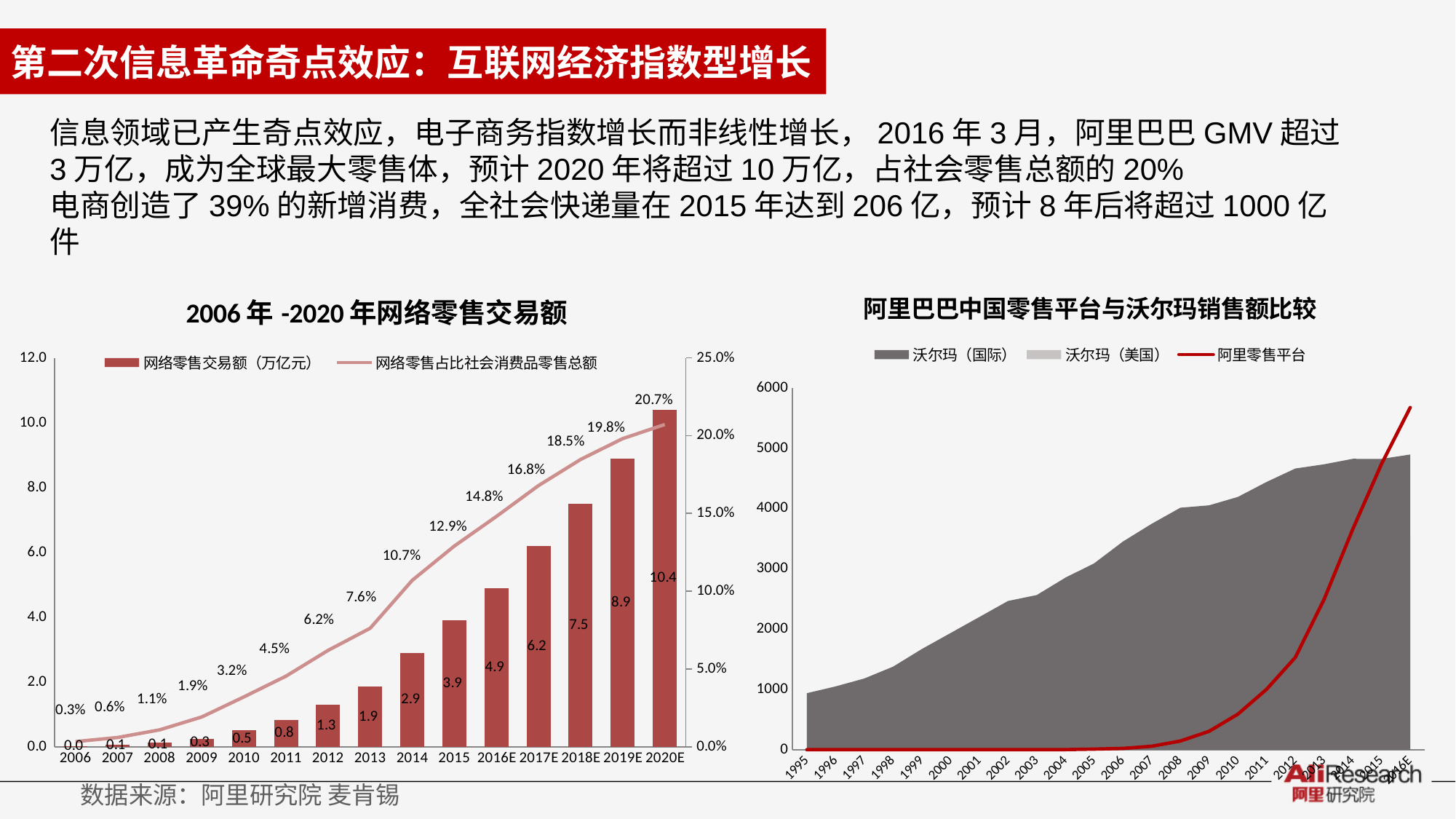
In the chart titled 2006年-2020年网络零售交易额, how many series does the legend list? 2 In the chart titled 阿里巴巴中国零售平台与沃尔玛销售额比较, what colour is the 阿里零售平台 line? red In the chart titled 2006年-2020年网络零售交易额, does the 网络零售占比社会消费品零售总额 line rise or fall from 2006 to 2020E? rise In the chart titled 阿里巴巴中国零售平台与沃尔玛销售额比较, is the value for 阿里零售平台 in 2005 greater or less than 1000? less In the chart titled 2006年-2020年网络零售交易额, what is the 网络零售交易额 value for 2015? 3.9 In the chart titled 阿里巴巴中国零售平台与沃尔玛销售额比较, how many series does the legend list? 3 In the chart titled 2006年-2020年网络零售交易额, what is the 网络零售占比社会消费品零售总额 value for 2013? 7.6% In the chart titled 2006年-2020年网络零售交易额, how many years are shown on the x axis? 15 In the chart titled 2006年-2020年网络零售交易额, which year has the highest 网络零售交易额? 2020E In the chart titled 阿里巴巴中国零售平台与沃尔玛销售额比较, is the value for 阿里零售平台 in 2016E greater or less than 5000? greater In the chart titled 2006年-2020年网络零售交易额, what is the difference in 网络零售交易额 between 2020E and 2019E? 1.5 In the chart titled 2006年-2020年网络零售交易额, which is larger, the 网络零售交易额 for 2014 or for 2012? 2014